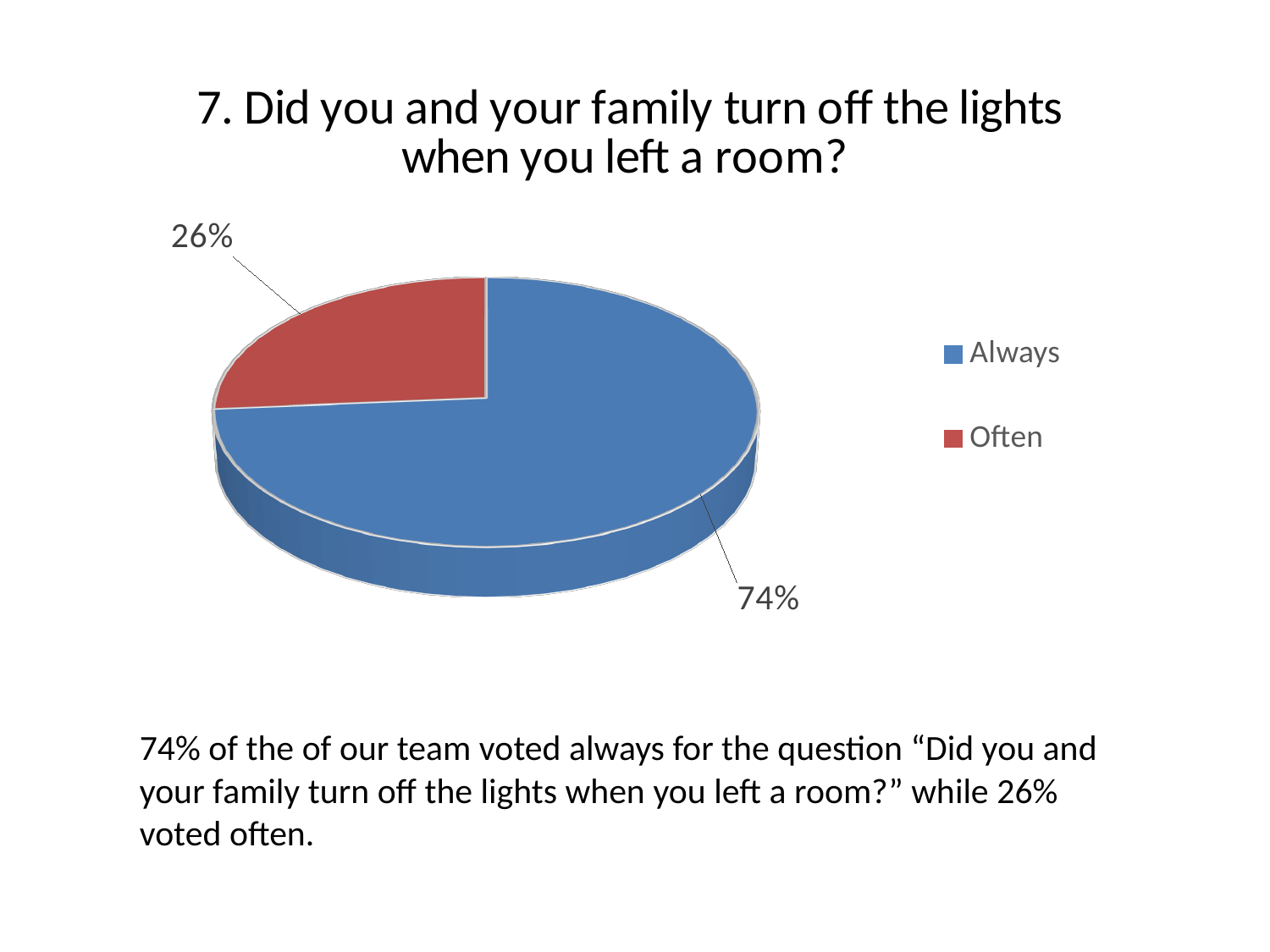
What share of the pie does the Often slice represent? 26% Which slice is larger, Always or Often? Always What colour is the Always slice? blue Which category has the smallest slice of the pie? Often What is the title of the chart on the slide? 7. Did you and your family turn off the lights when you left a room? How many slices does the pie chart have? 2 What percentage of the pie is labelled for the Always slice? 74% Which category has the largest slice of the pie? Always What is the difference in percentage points between the Always and Often slices? 48 What kind of chart is shown on the slide? pie chart How many entries does the legend list? 2 What percentage of the pie is labelled for the Often slice? 26%